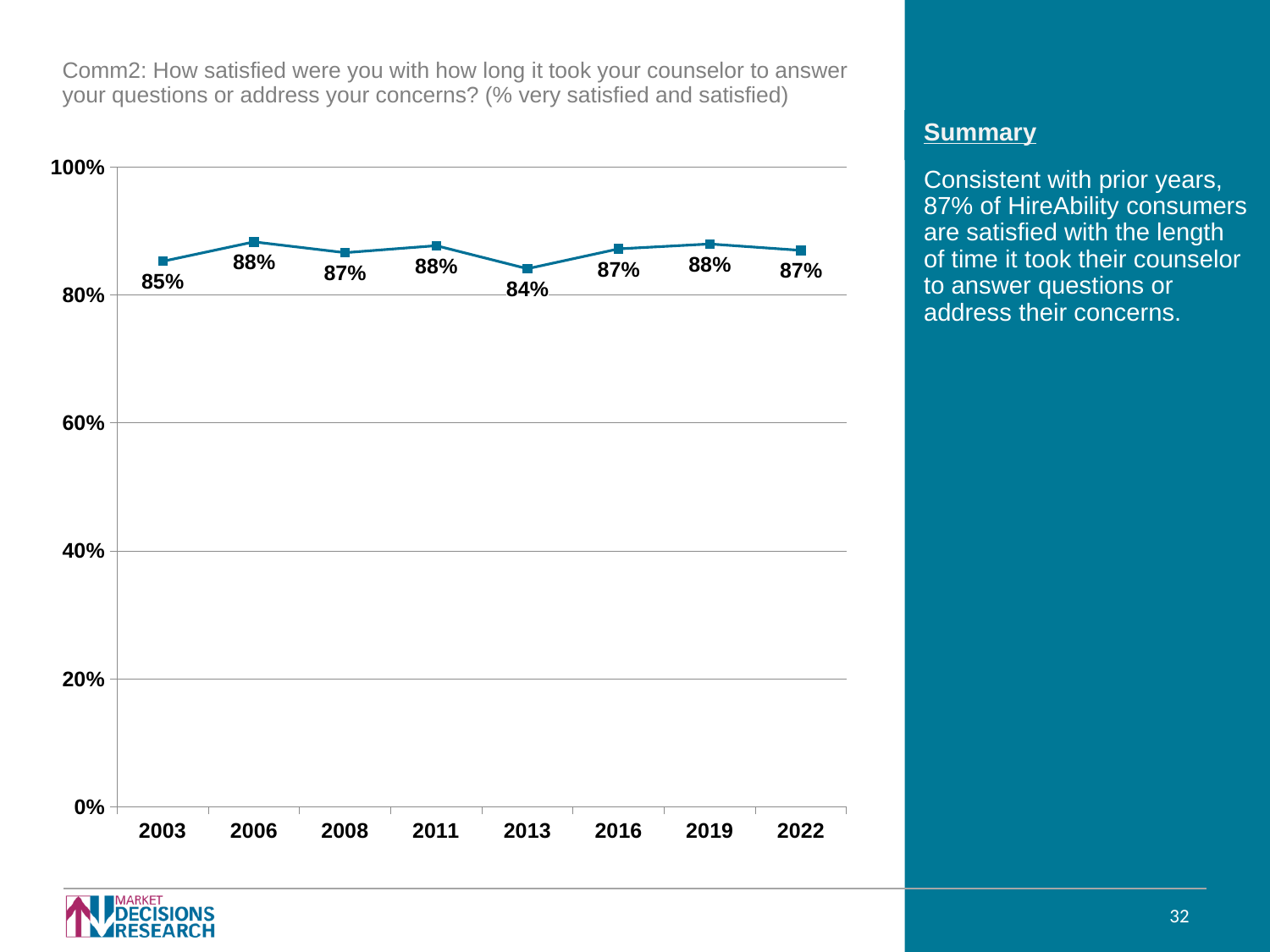
Which year has the lowest value? 2013 How many years are plotted on the chart? 8 What kind of chart is shown on the slide? line chart What is the difference between the values for 2022 and 2003? 2% What is the value for 2003? 85% What is the value for 2019? 88% Is the value for 2013 greater or less than 80%? greater Did the value rise or fall from 2019 to 2022? fall What is the difference between the values for 2006 and 2013? 4% What is the value for 2013? 84% What is the value for 2022? 87% Which is larger, the value for 2003 or the value for 2006? 2006